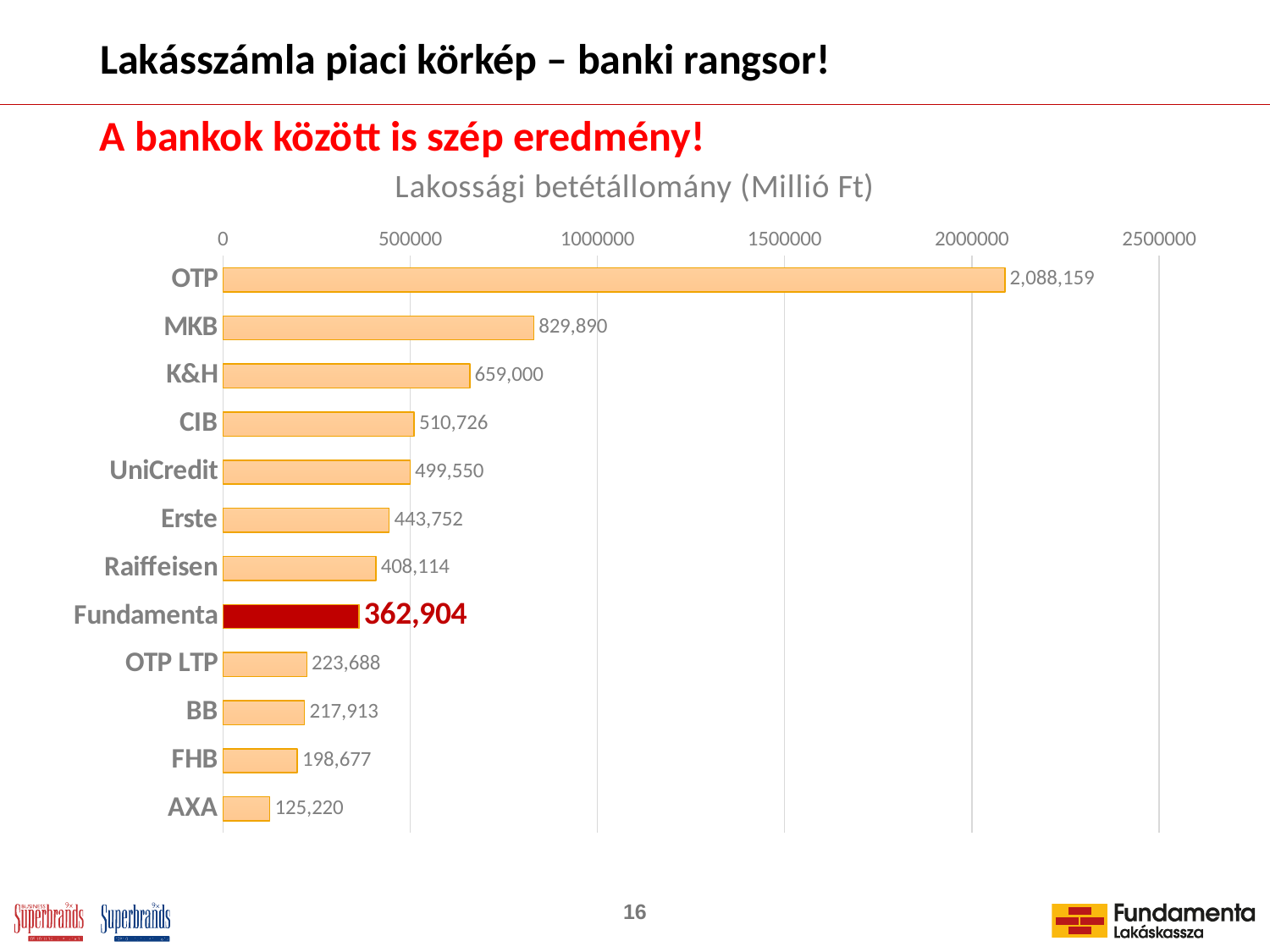
What is the value for Raiffeisen? 408,114 Which is larger, the value for Erste or the value for Raiffeisen? Erste Which bank has the highest value? OTP How many banks are shown in the chart? 12 What is the value for OTP? 2,088,159 What is the title of the chart? Lakossági betétállomány (Millió Ft) What is the difference between the values for MKB and K&H? 170,890 Which bank has the lowest value? AXA What is the value for Fundamenta? 362,904 Is the value for CIB greater or less than 500000? greater What kind of chart is shown on the slide? bar chart Which bank's bar is coloured dark red instead of orange? Fundamenta